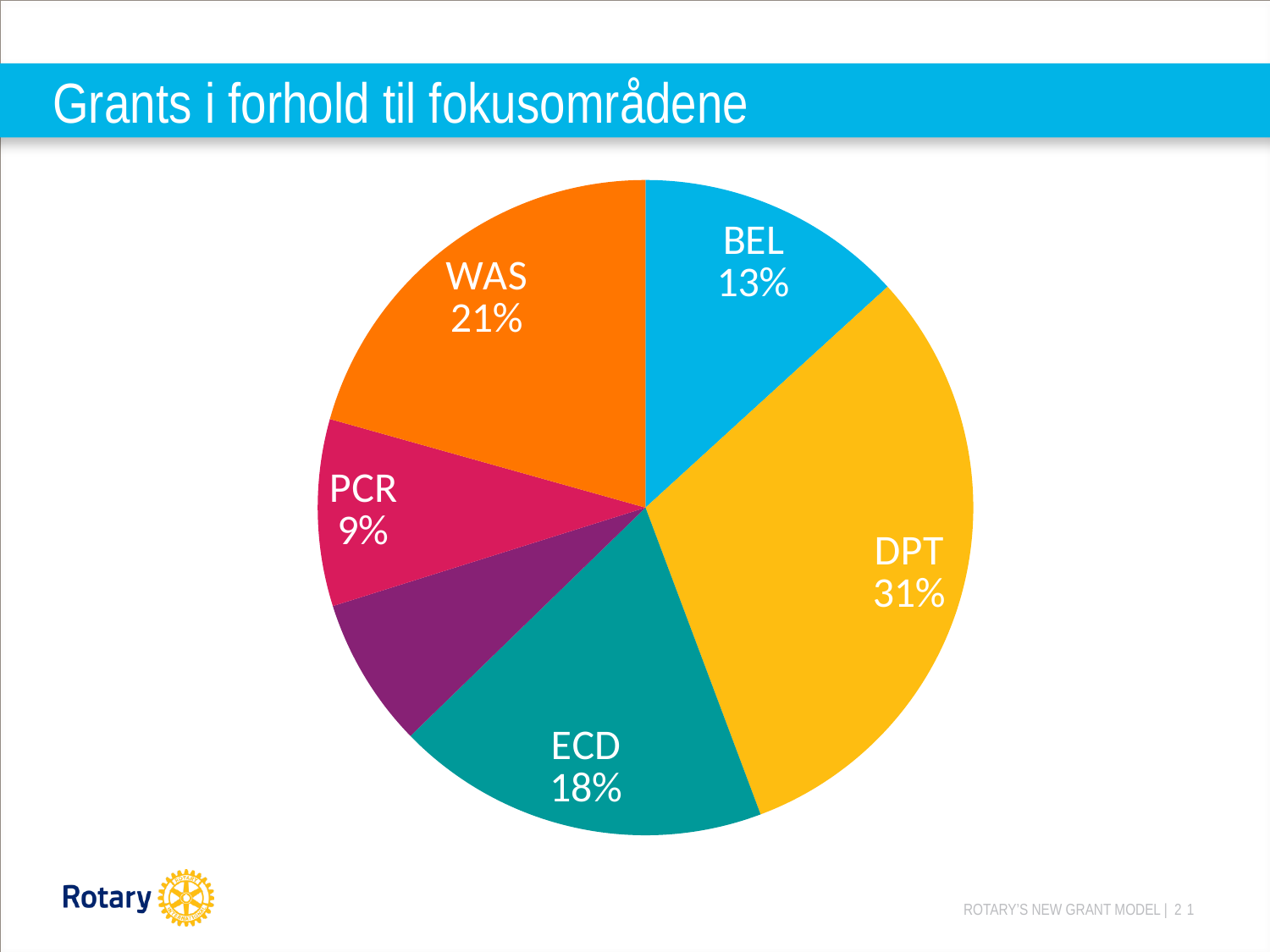
What percentage is shown for PCR? 9% How many percentage points larger is DPT's share than BEL's share? 18 What percentage is shown for WAS? 21% What percentage is shown for ECD? 18% Which is larger, the share for WAS or the share for ECD? WAS What kind of chart is shown on the slide? pie chart What share of the pie does DPT have? 31% What is the title of the chart on the slide? Grants i forhold til fokusområdene How many slices does the pie chart have? 6 Which is larger, the share for BEL or the share for PCR? BEL What percentage is shown for BEL? 13% Which labelled slice has the largest share of the pie? DPT